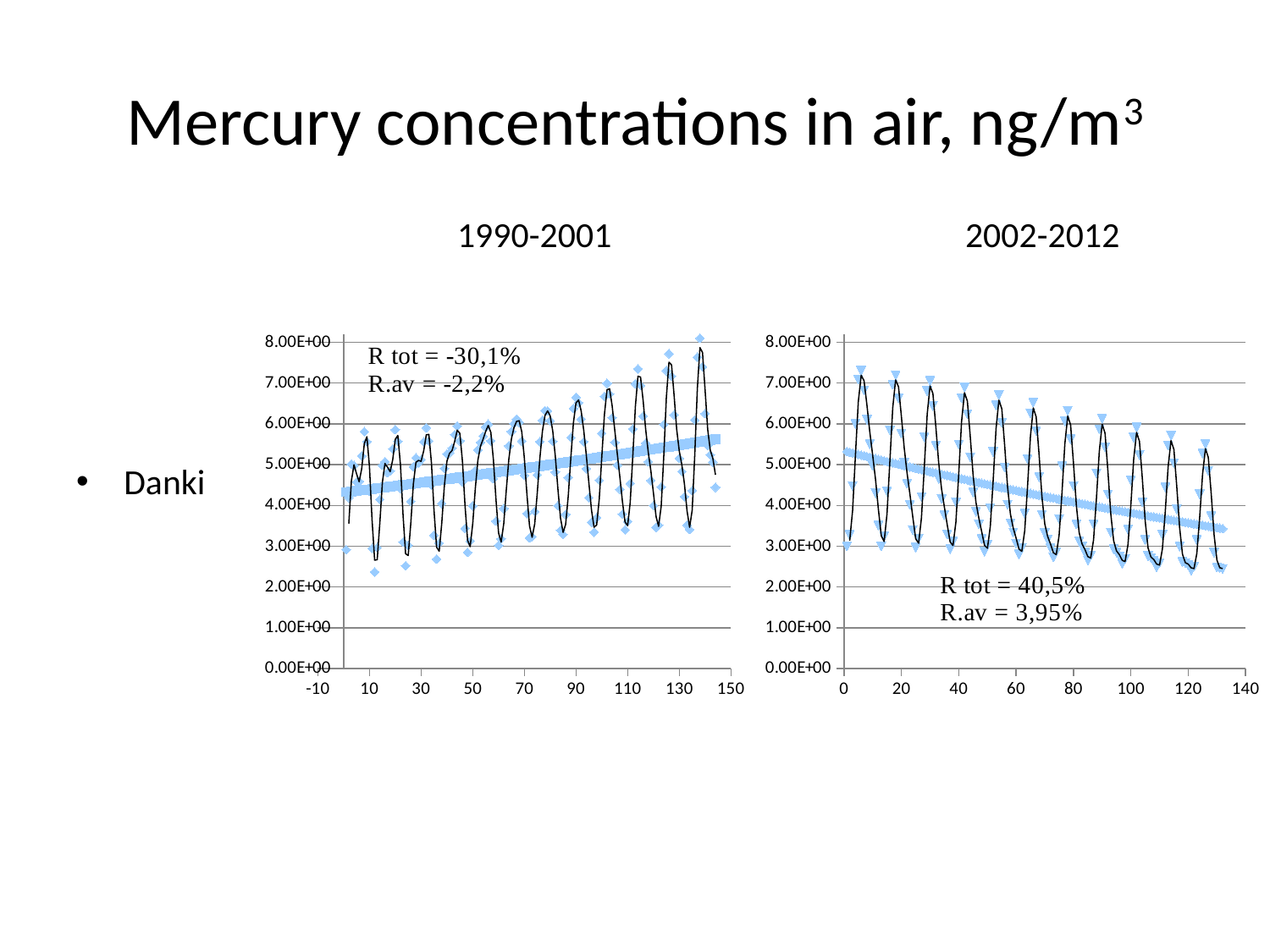
In the 1990-2001 chart, does the thick trend line rise or fall along the x axis? rise In the 2002-2012 chart, is the trend line value at x = 130 greater or less than 4.00E+00? less In the 2002-2012 chart, is the trend line value at x = 0 greater or less than 5.00E+00? greater What kind of chart is the 1990-2001 chart? scatter chart In the 2002-2012 chart, does the thick trend line rise or fall along the x axis? fall At the right end of the x axis, is the trend line higher in the 1990-2001 chart or in the 2002-2012 chart? 1990-2001 What is the R tot value printed on the 1990-2001 chart? -30,1% In the 1990-2001 chart, is the trend line value at x = 140 greater or less than 5.00E+00? greater What is the R.av value printed on the 2002-2012 chart? 3,95% How many charts are shown on the slide? 2